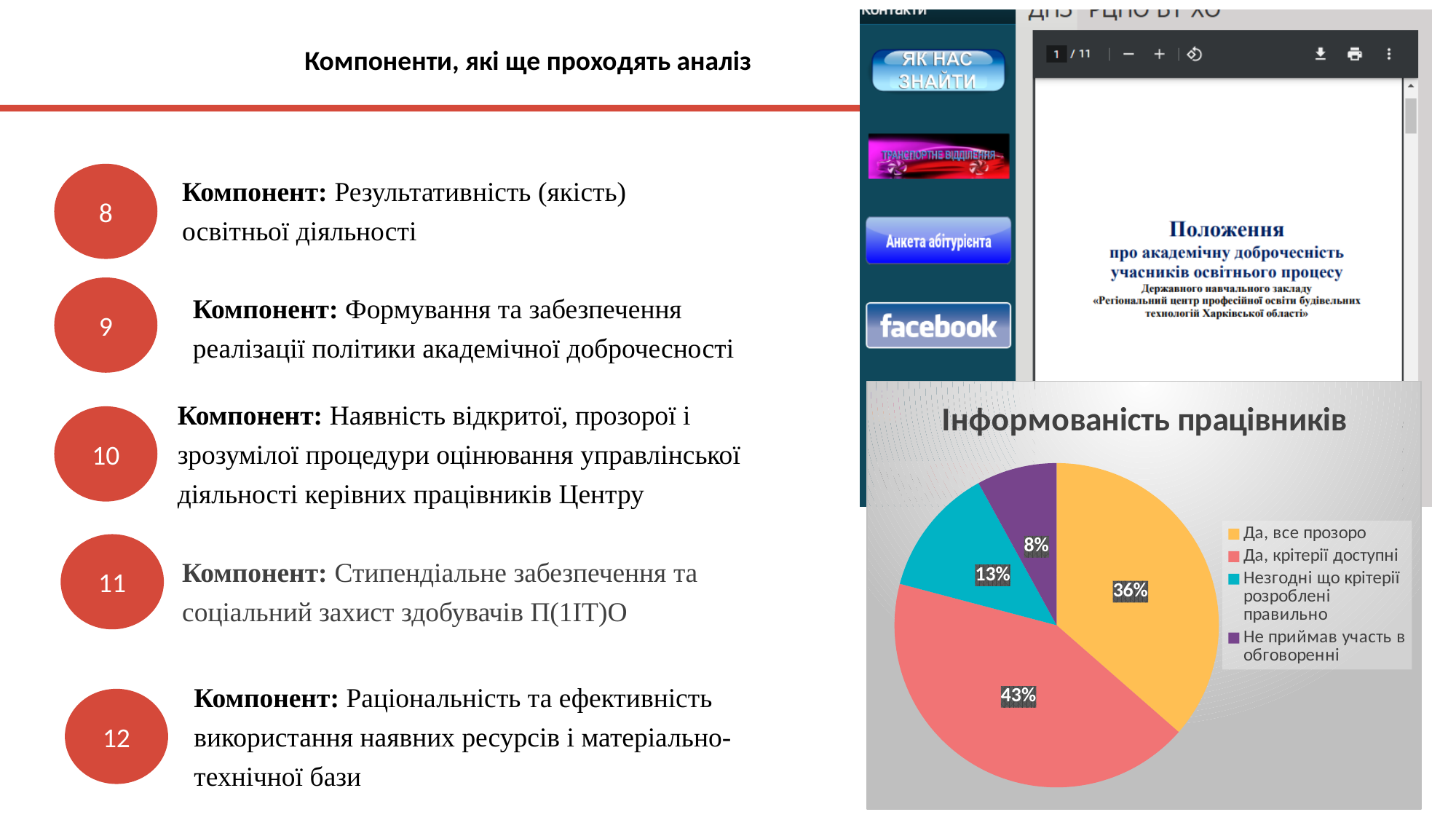
What colour is the slice for "Да, все прозоро"? yellow Which is larger: the slice for "Незгодні що крітерії розроблені правильно" or the slice for "Не приймав участь в обговоренні"? Незгодні що крітерії розроблені правильно Which category has the largest slice of the pie? Да, крітерії доступні What share of the pie does "Да, крітерії доступні" have? 43% What share of the pie does "Да, все прозоро" have? 36% What share of the pie does "Незгодні що крітерії розроблені правильно" have? 13% What share of the pie does "Не приймав участь в обговоренні" have? 8% What type of chart is shown on the slide? pie chart How many slices does the pie chart have? 4 What is the title of the pie chart? Інформованість працівників What is the difference in percentage points between "Да, крітерії доступні" and "Да, все прозоро"? 7 Which category has the smallest slice of the pie? Не приймав участь в обговоренні